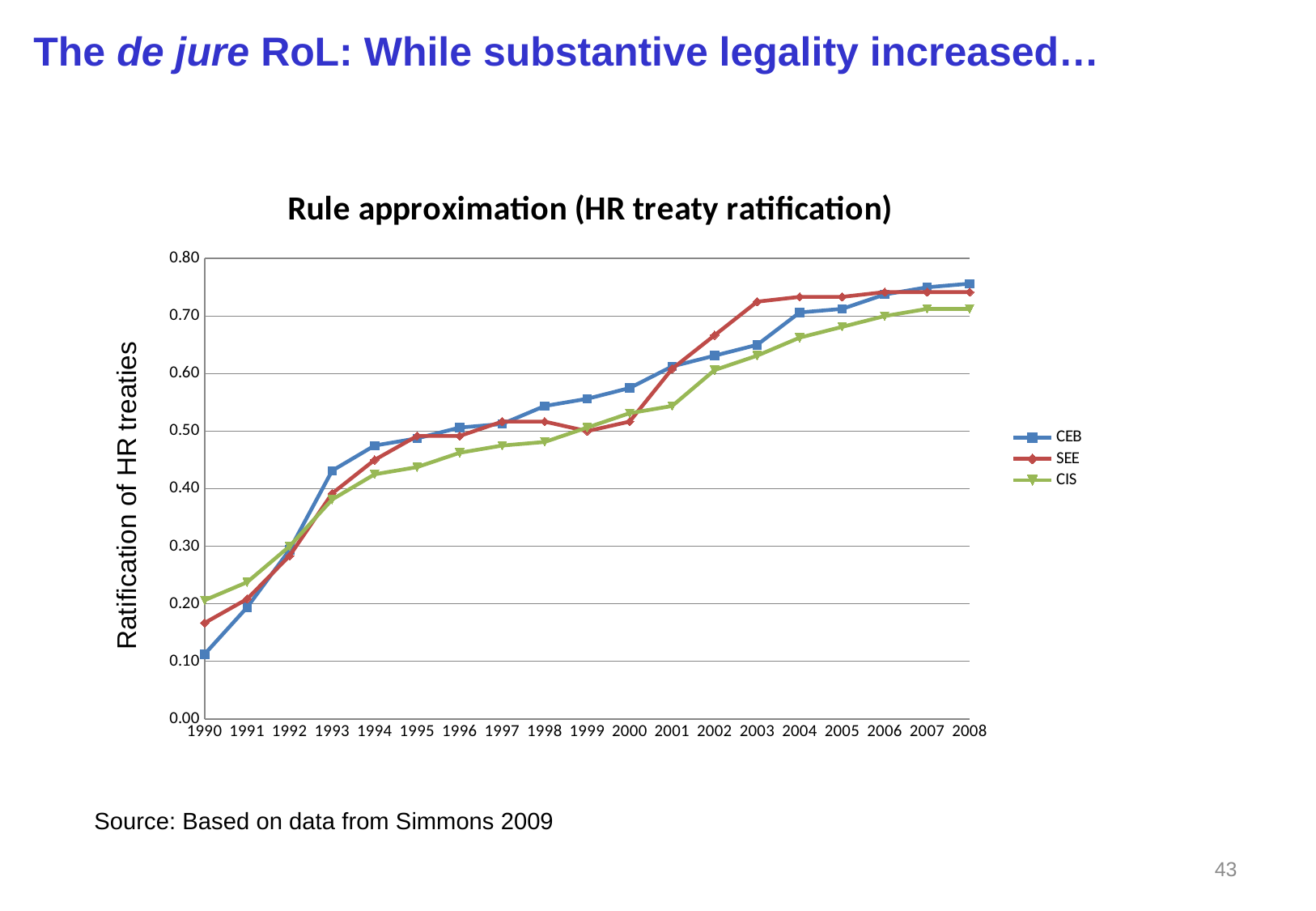
Which series has the lowest value in 2008? CIS What kind of chart is shown on the slide? Line chart In 1990, which series has a higher value, CIS or CEB? CIS Is the value for CIS in 2003 greater or less than 0.60? greater How many series does the legend list? 3 Do the values for CEB generally rise or fall from 1990 to 2008? Rise Is the value for SEE in 2003 greater or less than 0.70? greater Is the value for CEB in 1990 greater or less than 0.20? less How many years are plotted along the x axis? 19 In 2003, which series has a higher value, SEE or CIS? SEE What is the title of the chart? Rule approximation (HR treaty ratification)